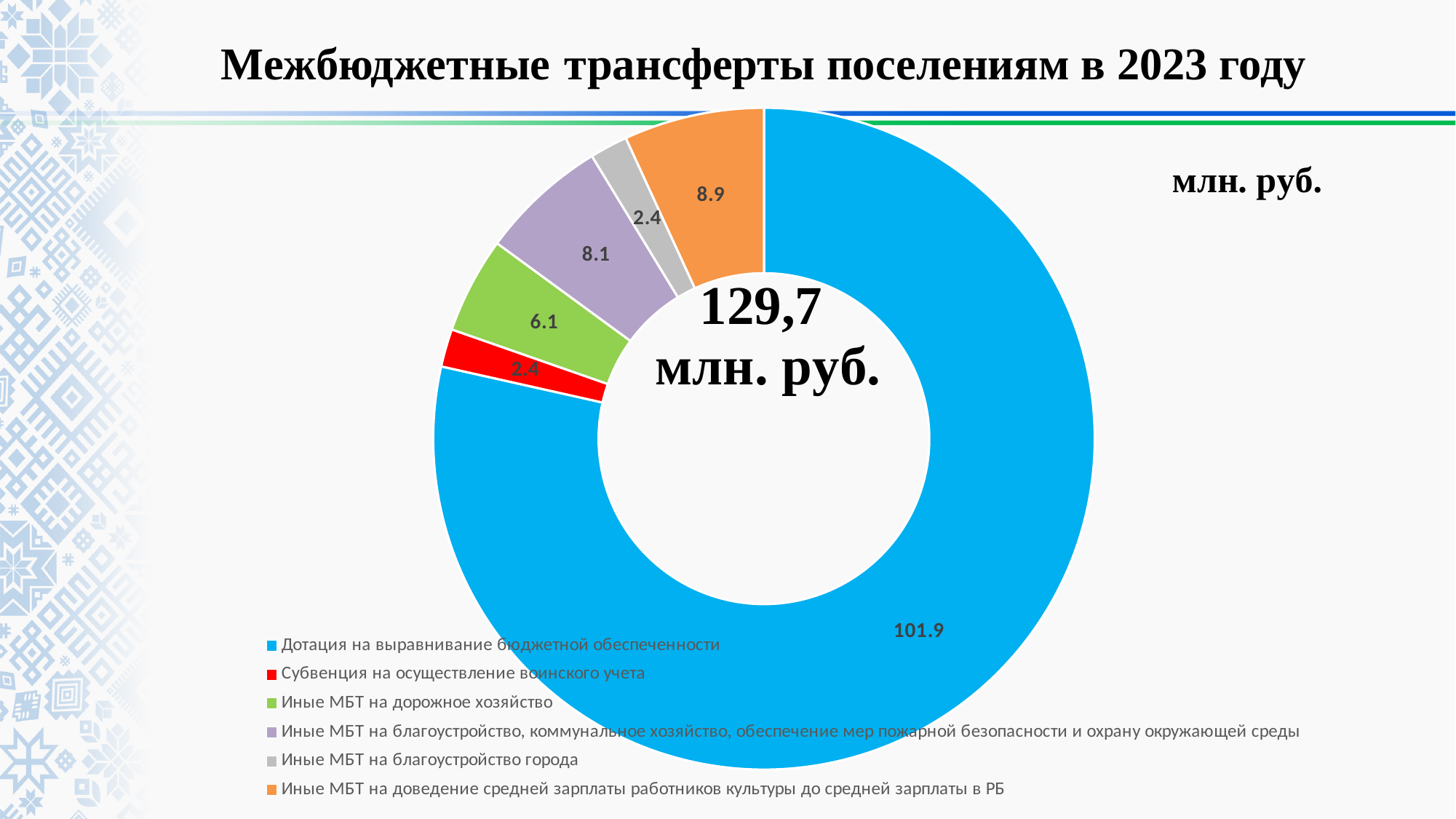
What total is shown in the centre of the chart? 129,7 млн. руб. What type of chart is shown on the slide? Doughnut (pie) chart What is the value for «Иные МБТ на благоустройство, коммунальное хозяйство, обеспечение мер пожарной безопасности и охрану окружающей среды»? 8.1 What is the value for «Иные МБТ на дорожное хозяйство»? 6.1 What is the difference between the value for «Иные МБТ на доведение средней зарплаты работников культуры до средней зарплаты в РБ» and the value for «Иные МБТ на благоустройство, коммунальное хозяйство, обеспечение мер пожарной безопасности и охрану окружающей среды»? 0.8 What is the value for «Дотация на выравнивание бюджетной обеспеченности»? 101.9 What colour is the slice for «Субвенция на осуществление воинского учета»? Red How many categories does the legend list? 6 Which is larger: the value for «Иные МБТ на дорожное хозяйство» or the value for «Иные МБТ на благоустройство города»? Иные МБТ на дорожное хозяйство What is the value for «Субвенция на осуществление воинского учета»? 2.4 Which category has the largest value? Дотация на выравнивание бюджетной обеспеченности What is the value for «Иные МБТ на доведение средней зарплаты работников культуры до средней зарплаты в РБ»? 8.9